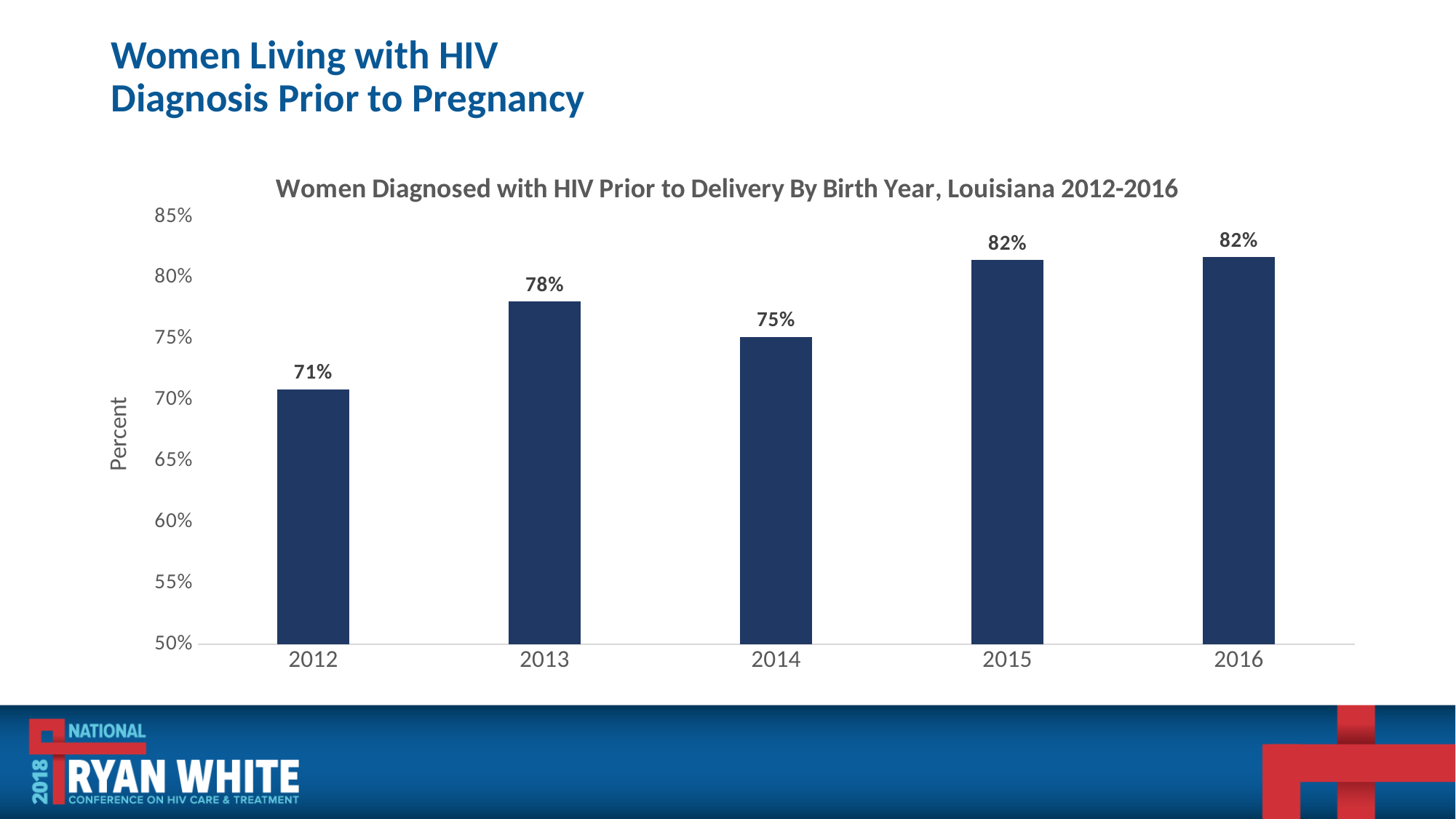
Which is larger, the value for 2013 or the value for 2014? 2013 What is the difference between the values for 2013 and 2014? 3% What is the value for 2014? 75% Which year has the lowest value? 2012 Is the value for 2015 greater or less than 80%? greater What is the value for 2013? 78% How many years are shown on the x axis? 5 What is the value for 2012? 71% What kind of chart is this? bar chart What is the difference between the values for 2016 and 2012? 11% Do the values generally rise or fall from 2012 to 2016? rise What is the title of the chart? Women Diagnosed with HIV Prior to Delivery By Birth Year, Louisiana 2012-2016